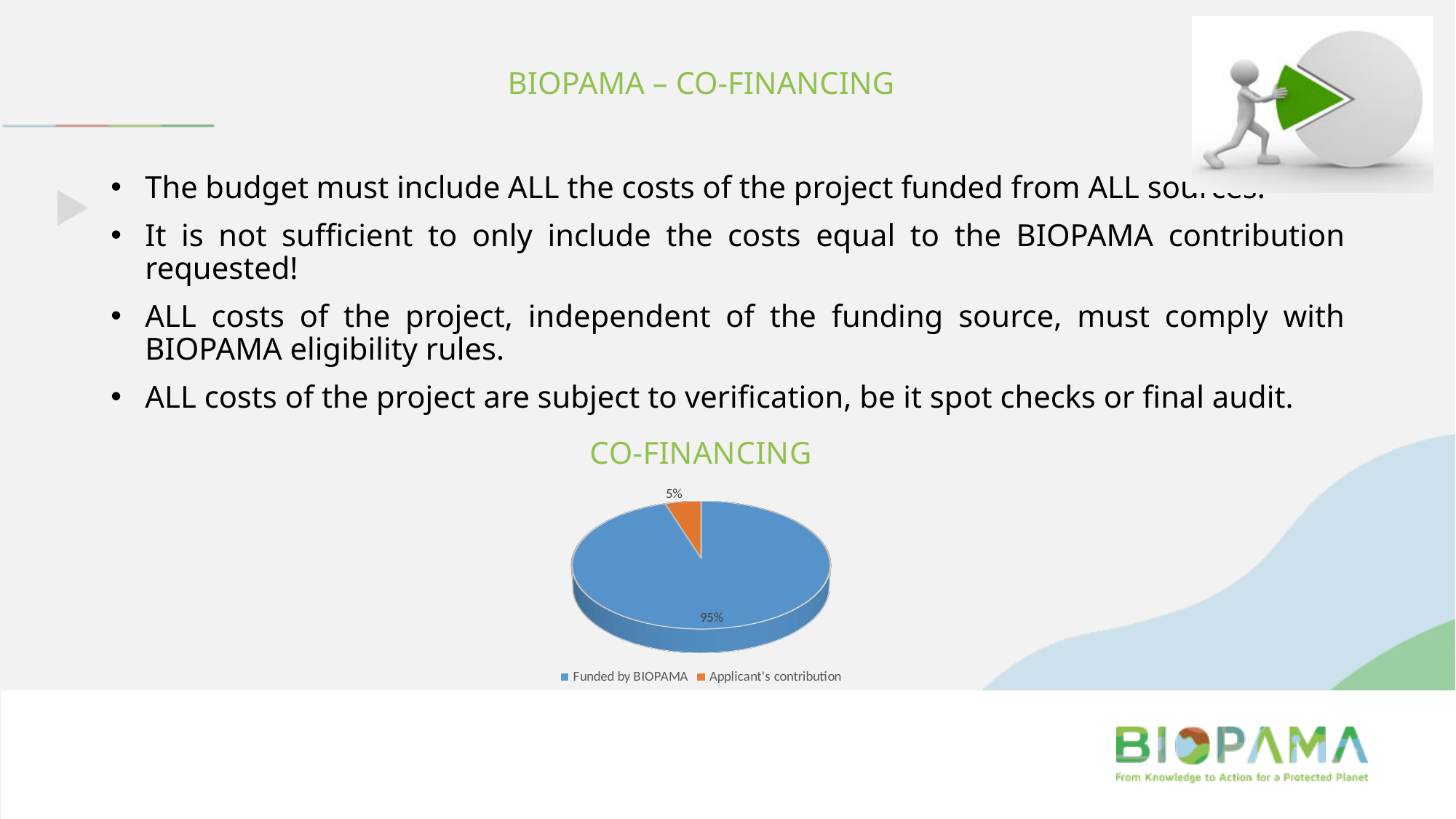
What kind of chart is shown on the slide? Pie chart What is the difference in percentage points between the Funded by BIOPAMA slice and the Applicant's contribution slice? 90 How many slices does the pie chart have? 2 What is the title of the chart? CO-FINANCING Which slice of the pie is the largest? Funded by BIOPAMA What share of the pie is Funded by BIOPAMA? 95% Which slice of the pie is the smallest? Applicant's contribution How many entries does the legend list? 2 Which is larger, the Funded by BIOPAMA slice or the Applicant's contribution slice? Funded by BIOPAMA What colour is the Applicant's contribution slice? Orange What share of the pie is the Applicant's contribution? 5%